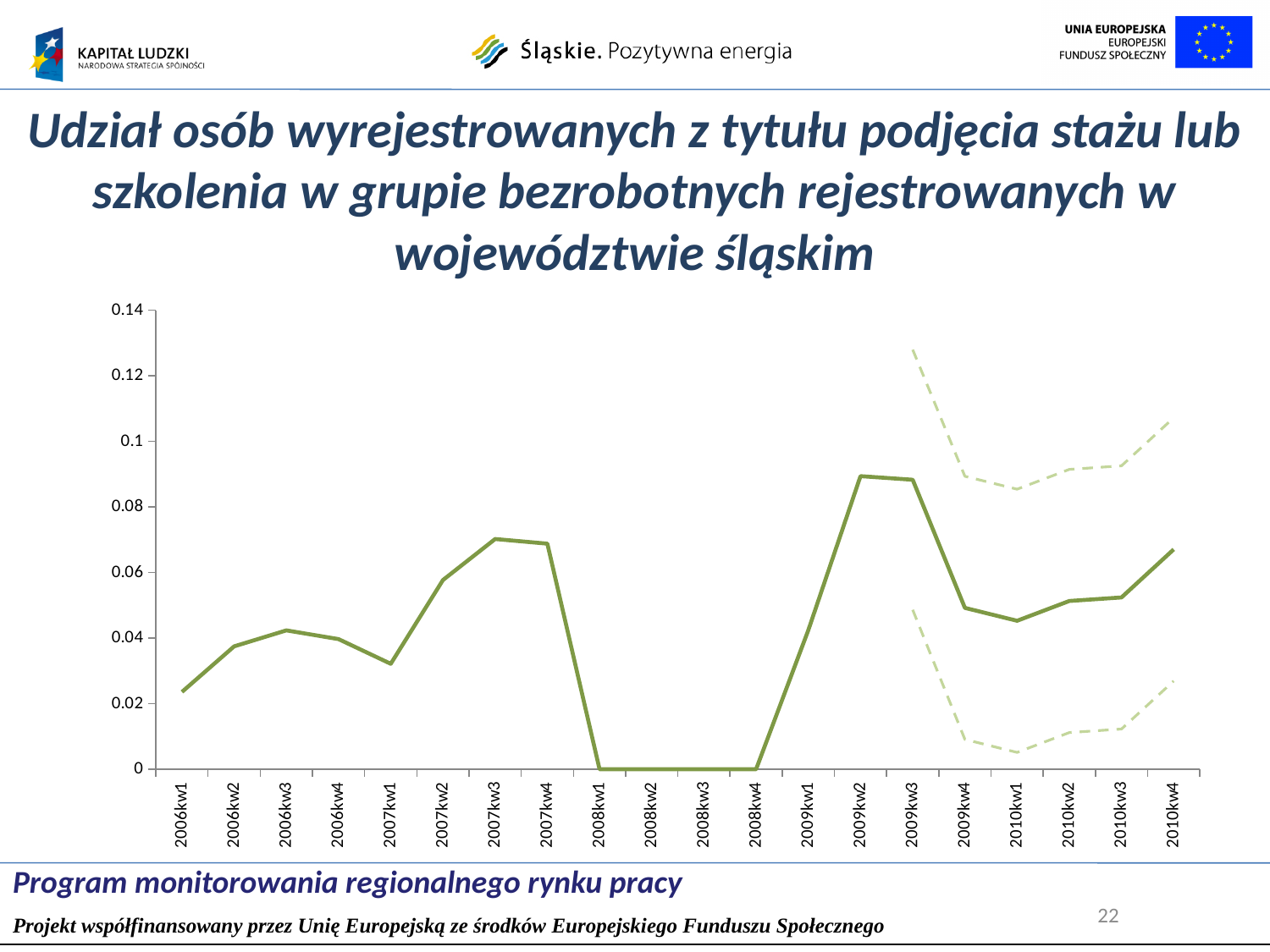
Which has the higher value on the solid line, 2007kw3 or 2006kw3? 2007kw3 Is the value of the solid line for 2006kw1 greater or less than 0.04? less Does the solid line rise or fall from 2009kw3 to 2010kw1? fall What kind of chart is shown on the slide? line chart Is the value of the solid line for 2007kw3 greater or less than 0.06? greater Which has the higher value on the solid line, 2010kw4 or 2010kw1? 2010kw4 Is the value of the solid line for 2009kw2 greater or less than 0.08? greater How many quarterly categories are shown on the x axis? 20 What is the value of the solid line for 2008kw2? 0 What is the highest tick value shown on the y axis? 0.14 How many dashed lines are plotted on the chart? 2